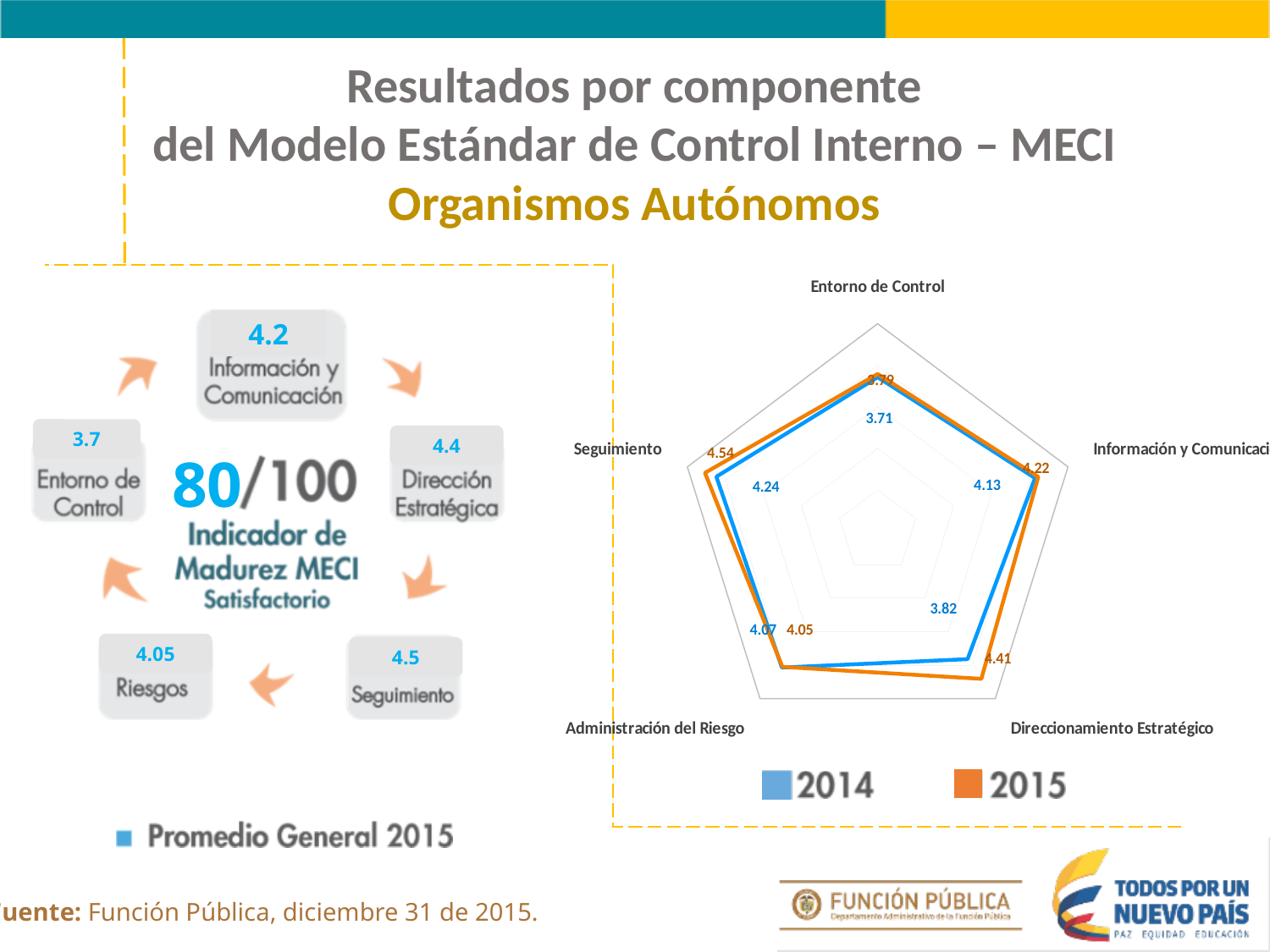
In the radar chart, what is the 2015 value for Direccionamiento Estratégico? 4.41 What kind of chart is shown on the right side of the slide? radar chart In the radar chart, what is the 2015 value for Seguimiento? 4.54 In the radar chart, what is the 2014 value for Información y Comunicación? 4.13 In the radar chart, which colour represents the 2015 series? orange In the radar chart, which year has the higher value for Seguimiento, 2014 or 2015? 2015 In the radar chart, which component has the lowest 2014 value? Entorno de Control In the radar chart, what is the 2014 value for Seguimiento? 4.24 In the radar chart, which component has the highest 2015 value? Seguimiento How many series does the legend of the radar chart list? 2 How many components (axes) does the radar chart have? 5 In the radar chart, by how much did Direccionamiento Estratégico increase from 2014 to 2015? 0.59